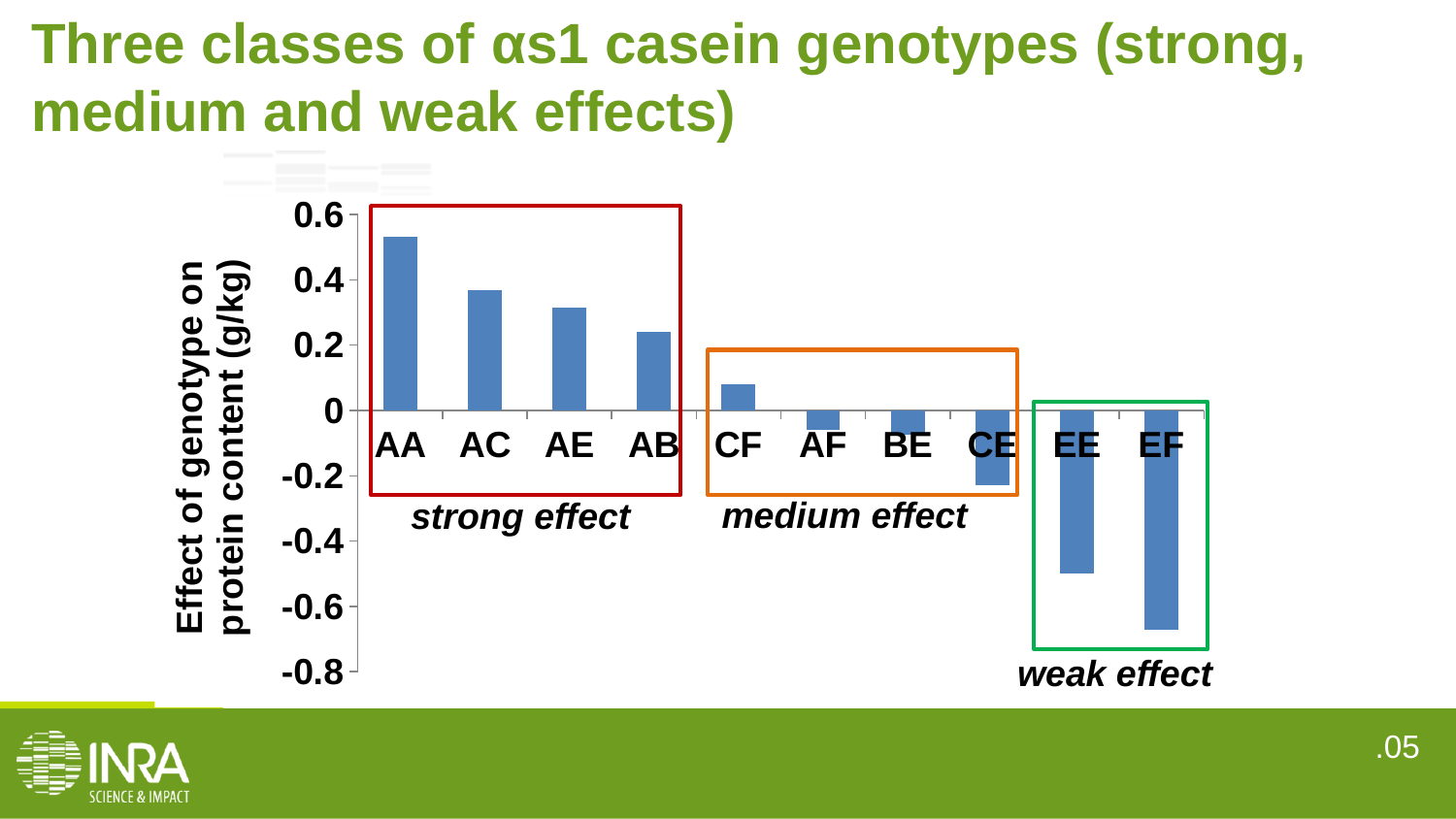
Is the value for AA greater or less than 0.4? greater Is the value for EE greater or less than -0.4? less Is the value for AC greater or less than 0.4? less Do the values rise or fall moving from left to right along the x axis? fall Which genotype has the highest effect on protein content? AA Which genotype has the lowest effect on protein content? EF How many genotypes are enclosed in the 'strong effect' box? 4 Which has the larger effect on protein content, AA or AC? AA What kind of chart is shown on the slide? bar chart Which has the larger (less negative) effect on protein content, EE or EF? EE How many genotype categories are plotted on the x axis? 10